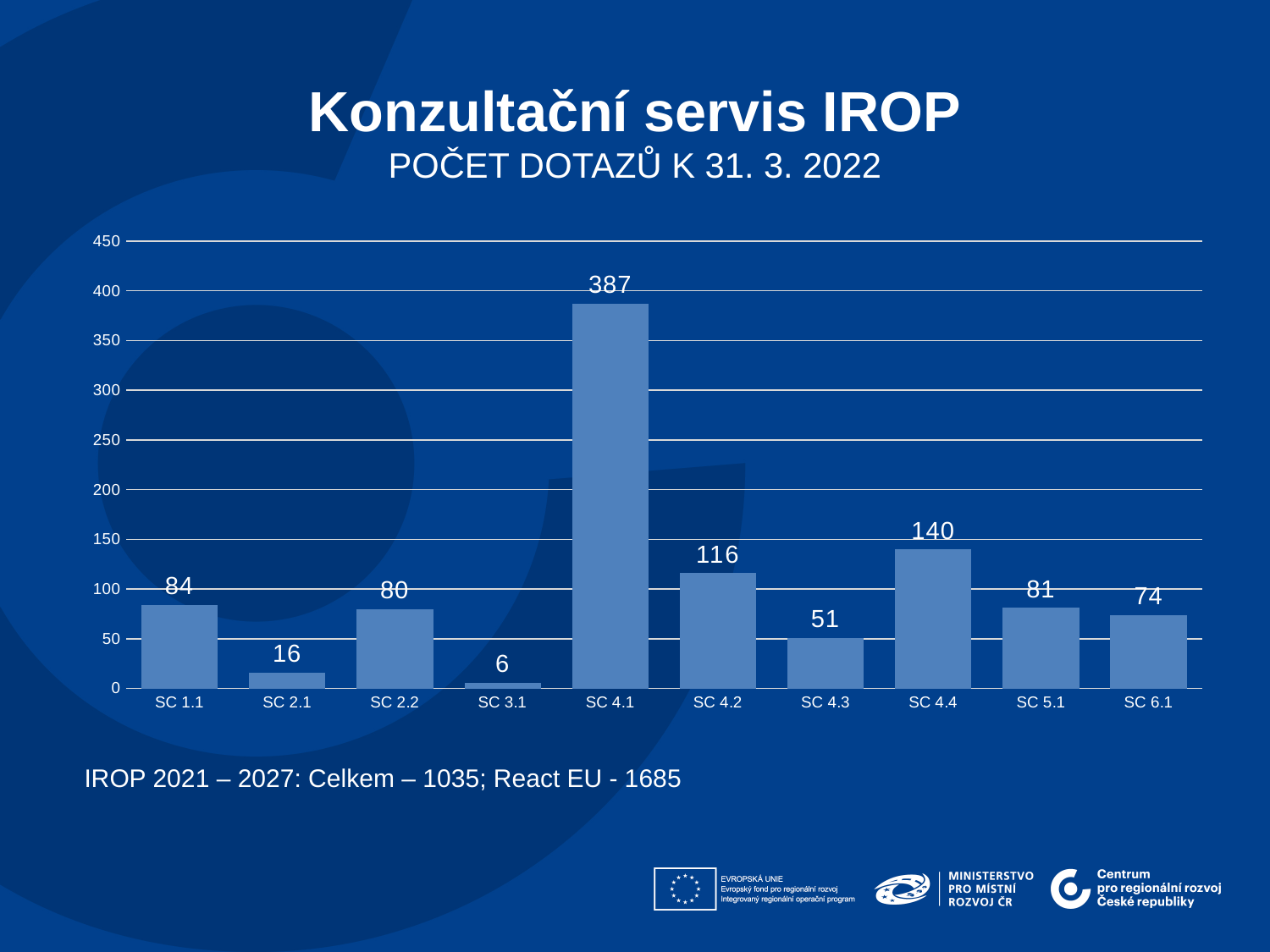
What is the difference between the values for SC 1.1 and SC 2.2? 4 What is the value for SC 2.1? 16 Which category has the highest value? SC 4.1 What is the value for SC 4.4? 140 How many categories are shown on the x axis? 10 Is the value for SC 4.2 greater or less than 100? greater Which is larger, the value for SC 4.3 or the value for SC 6.1? SC 6.1 What is the difference between the values for SC 4.1 and SC 4.2? 271 Which category has the lowest value? SC 3.1 What is the value for SC 4.1? 387 What kind of chart is shown on the slide? bar chart What is the subtitle shown above the chart? POČET DOTAZŮ K 31. 3. 2022